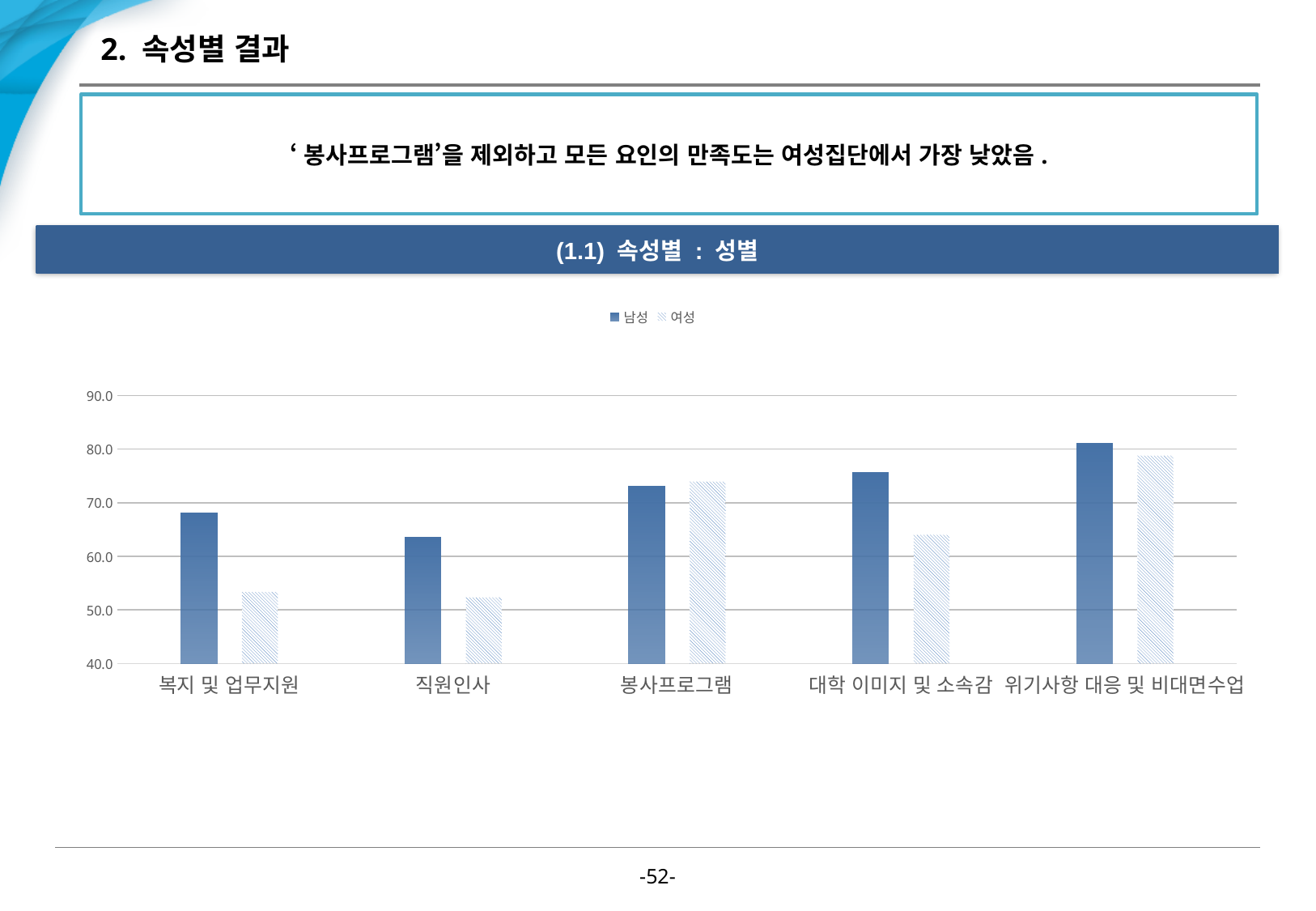
How many categories are shown on the x axis? 5 Is the value for 남성 in 대학 이미지 및 소속감 greater or less than 70? greater How many series does the legend list? 2 Is the value for 여성 in 복지 및 업무지원 greater or less than 60? less Which category has the lowest value for 남성? 직원인사 What kind of chart is shown on the slide? bar chart Which category has the highest value for 여성? 위기사항 대응 및 비대면수업 What are the two legend entries of the chart? 남성, 여성 For 대학 이미지 및 소속감, which series has the larger value, 남성 or 여성? 남성 For 복지 및 업무지원, which series has the larger value, 남성 or 여성? 남성 Is the value for 남성 in 위기사항 대응 및 비대면수업 greater or less than 80? greater Which category has the highest value for 남성? 위기사항 대응 및 비대면수업